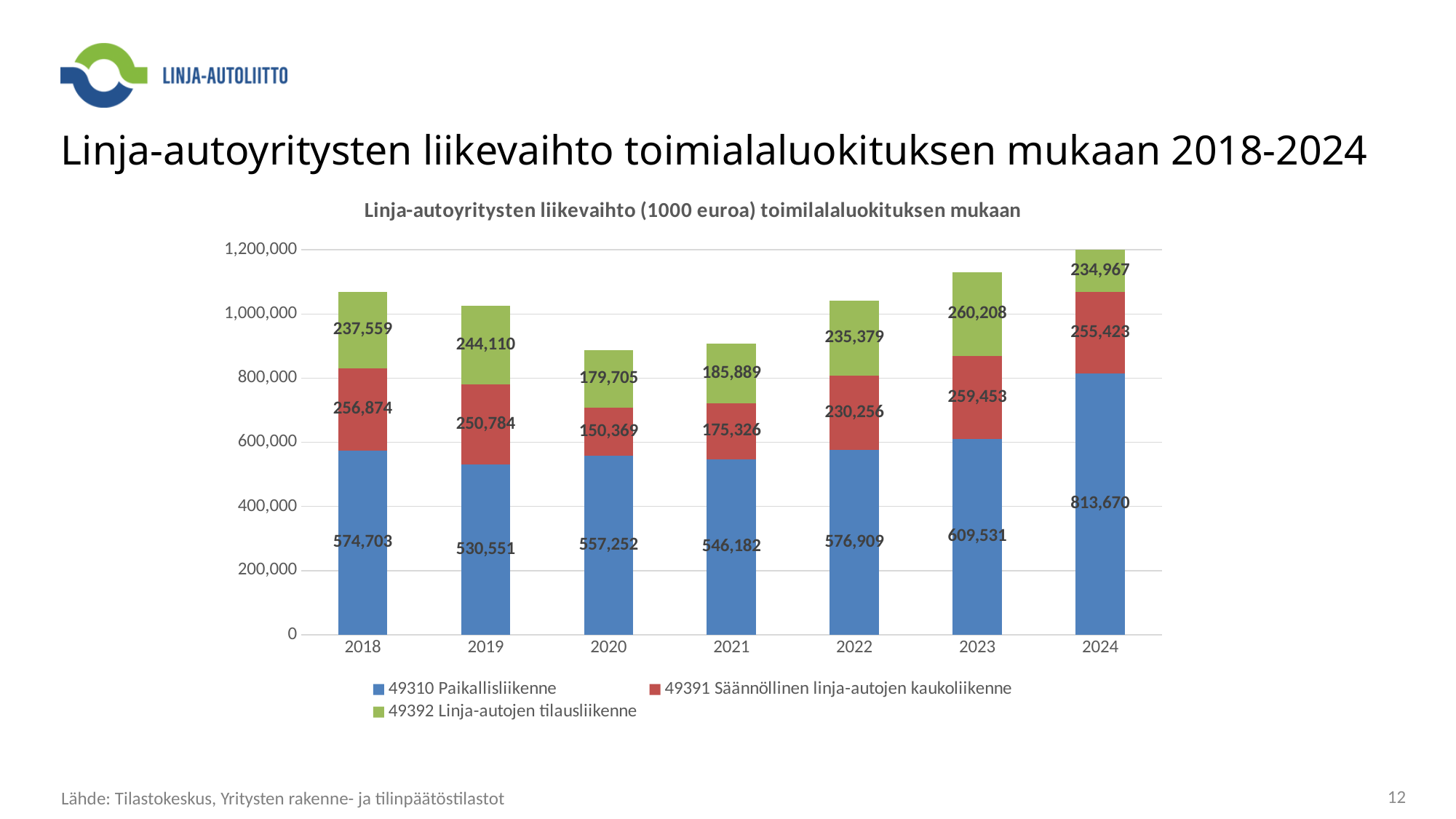
What is the value for 49310 Paikallisliikenne in 2024? 813,670 How many series does the legend list? 3 What is the difference between the 49310 Paikallisliikenne values for 2024 and 2023? 204,139 Which year has the lowest value for 49391 Säännöllinen linja-autojen kaukoliikenne? 2020 What is the total of the stacked bar for 2024? 1,304,060 What is the total of the stacked bar for 2020? 887,326 What is the value for 49391 Säännöllinen linja-autojen kaukoliikenne in 2020? 150,369 How many years are shown on the x axis? 7 What is the value for 49392 Linja-autojen tilausliikenne in 2019? 244,110 Which year has the highest value for 49310 Paikallisliikenne? 2024 What kind of chart is shown on the slide? Stacked bar chart Which is larger, the 49392 Linja-autojen tilausliikenne value for 2023 or for 2022? 2023